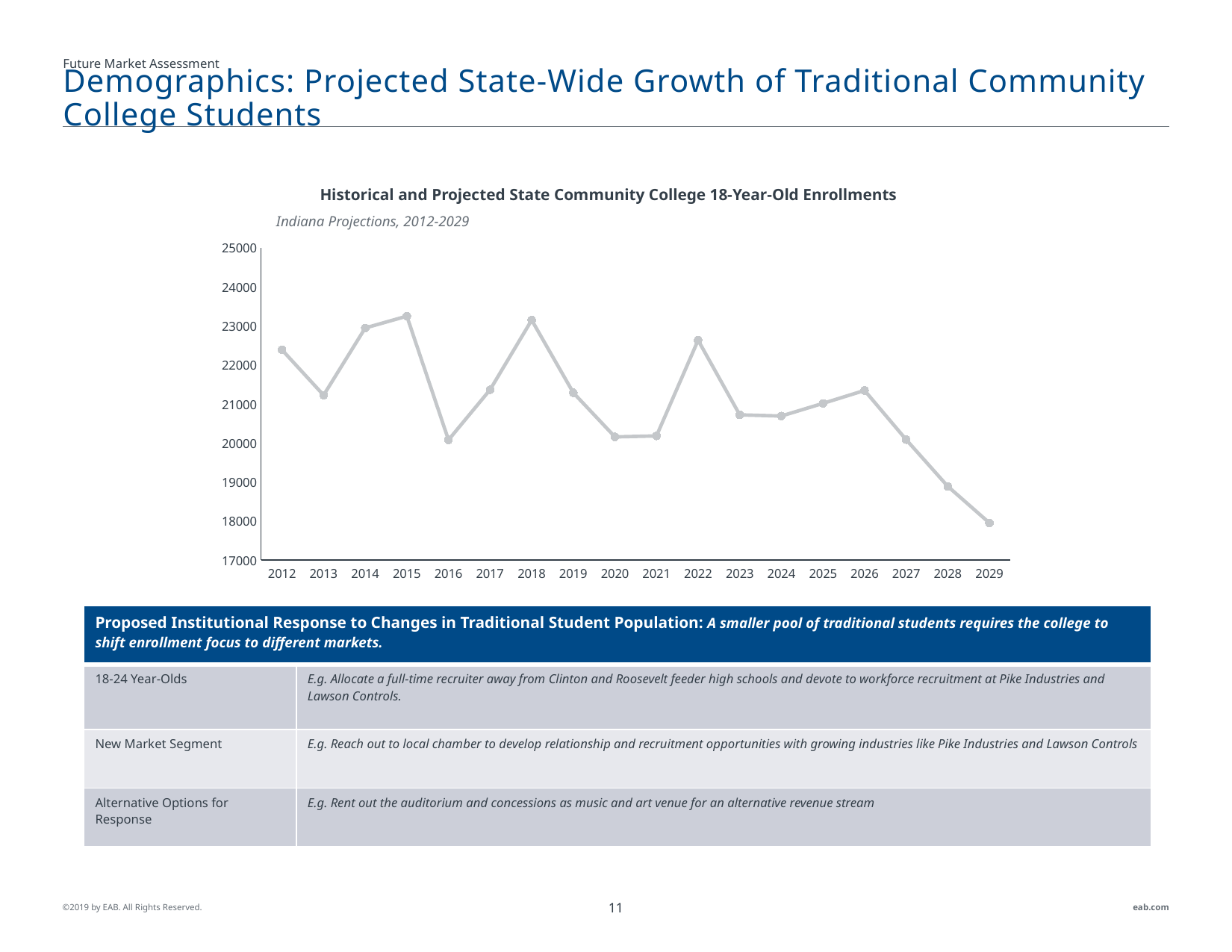
Which year has the larger value, 2016 or 2017? 2017 What kind of chart is shown on the slide? Line chart Is the value for 2015 greater or less than 23000? greater Which year has the larger value, 2012 or 2013? 2012 Is the value for 2022 greater or less than 22000? greater Is the value for 2016 greater or less than 21000? less Do the values rise or fall from 2026 to 2029? fall What is the title of the chart? Historical and Projected State Community College 18-Year-Old Enrollments Which year has the lowest enrollment value on the chart? 2029 How many years are plotted on the x axis of the chart? 18